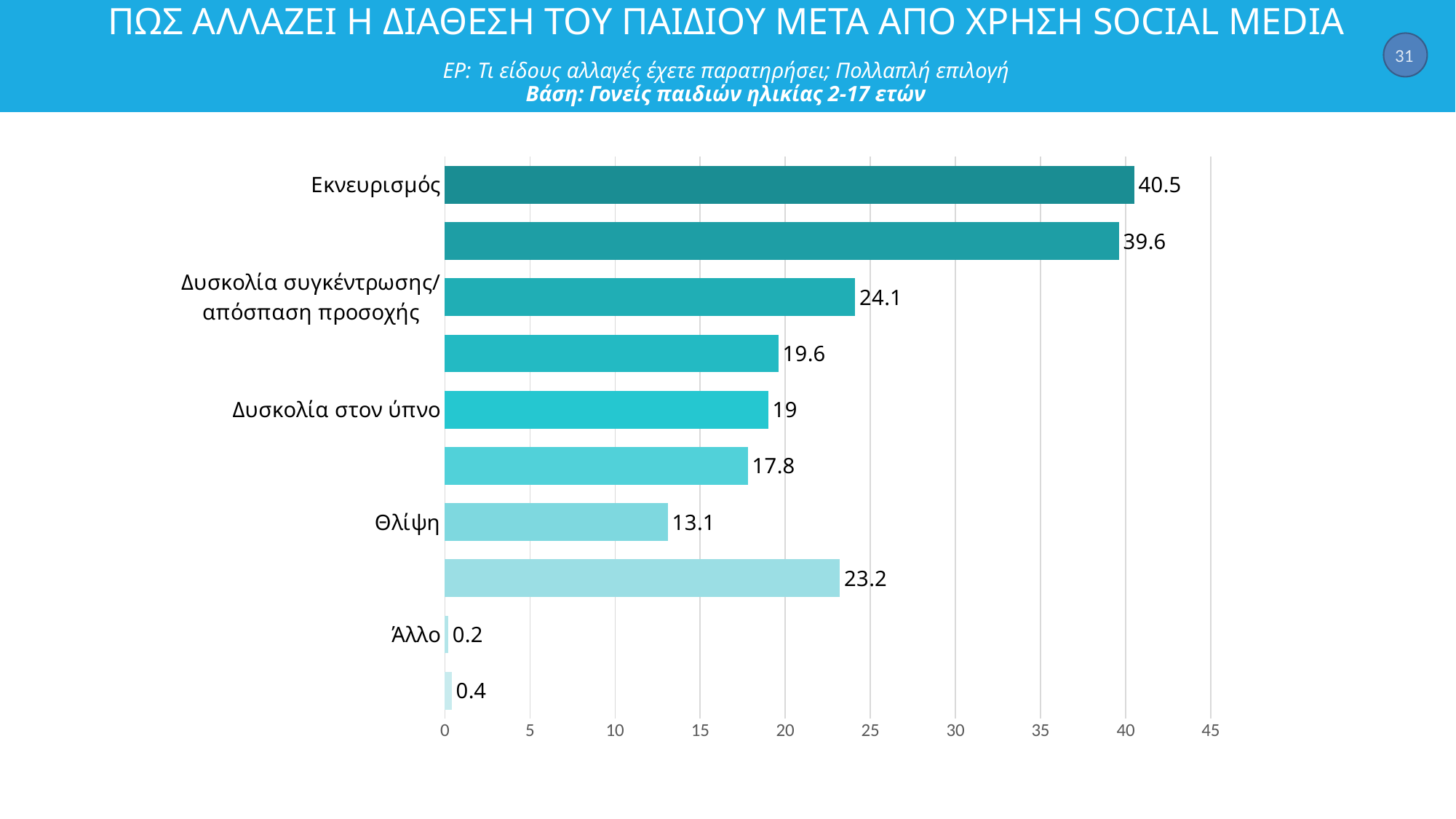
What is the value for Άλλο? 0.2 What is the value for Θλίψη? 13.1 Which labelled category has the lowest value? Άλλο Which is larger, the value for Δυσκολία στον ύπνο or the value for Θλίψη? Δυσκολία στον ύπνο What kind of chart is shown on the slide? Bar chart What is the difference between the values for Δυσκολία στον ύπνο and Θλίψη? 5.9 What is the value for Εκνευρισμός? 40.5 What is the value for Δυσκολία συγκέντρωσης/απόσπαση προσοχής? 24.1 How many bars are plotted in the chart? 10 What is the value for Δυσκολία στον ύπνο? 19 Which labelled category has the highest value? Εκνευρισμός What is the difference between the values for Εκνευρισμός and Δυσκολία συγκέντρωσης/απόσπαση προσοχής? 16.4